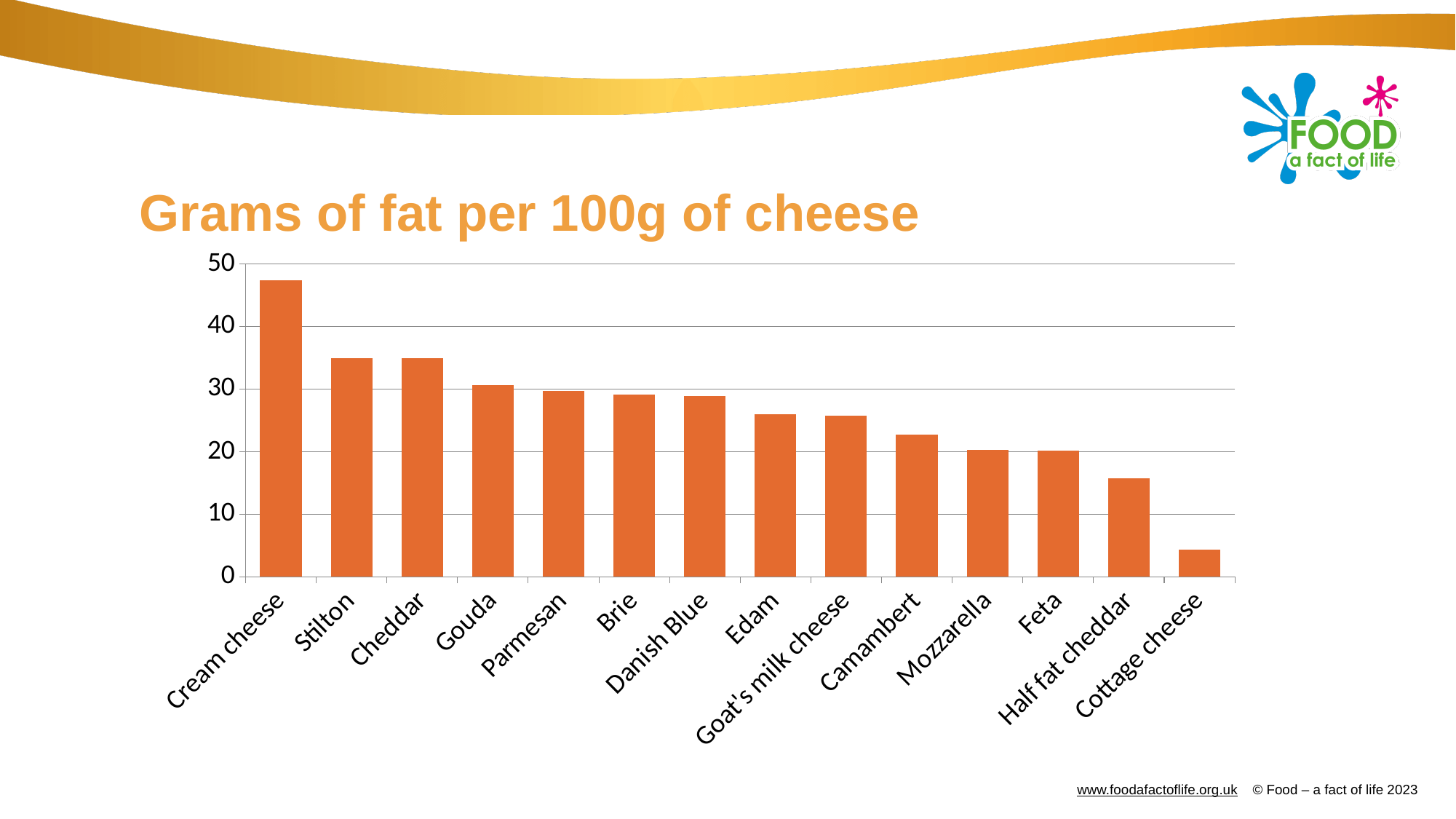
What kind of chart is shown on the slide? Bar chart Is the value for Cream cheese greater or less than 40? greater Which has more grams of fat per 100g, Camambert or Half fat cheddar? Camambert Which cheese has the highest grams of fat per 100g? Cream cheese Is the value for Edam greater or less than 20? greater How many cheeses are shown on the chart? 14 Which cheese has the lowest grams of fat per 100g? Cottage cheese What is the title of the chart? Grams of fat per 100g of cheese Do the values rise or fall moving from left to right along the x axis? Fall Is the value for Stilton greater or less than 40? less